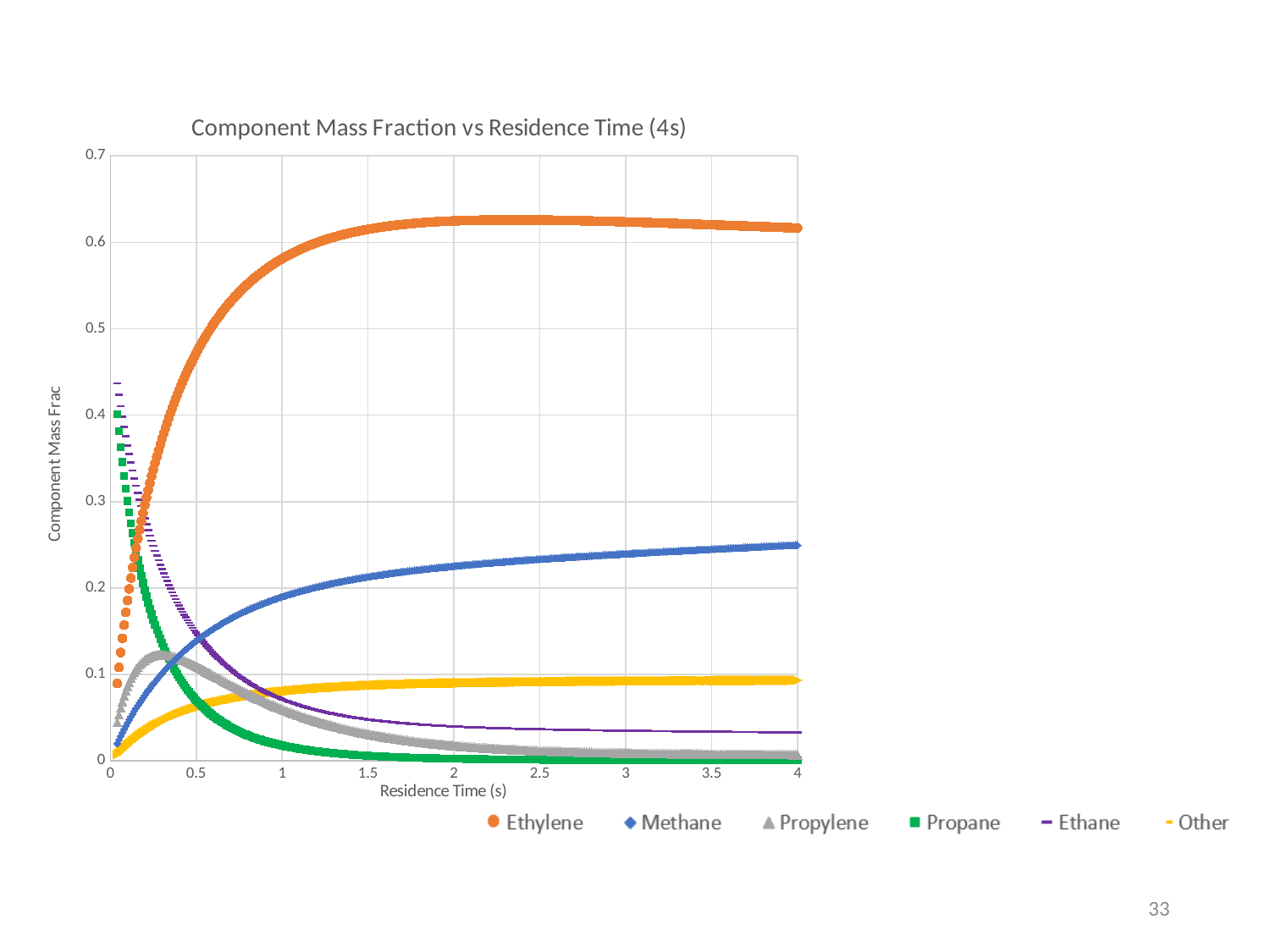
At a residence time of 4 s, which is larger, the value for Methane or the value for Ethane? Methane How many series does the legend list? 6 Is the value for Ethane at a residence time of 4 s greater or less than 0.1? less Does the Methane mass fraction rise or fall as residence time increases? rise Is the value for Methane at a residence time of 1 s greater or less than 0.3? less What kind of chart is shown on the slide? scatter chart Is the value for Ethylene at a residence time of 4 s greater or less than 0.6? greater What is the title of the chart? Component Mass Fraction vs Residence Time (4s) Which series has the highest mass fraction at a residence time of 4 s? Ethylene Does the Propane mass fraction rise or fall as residence time increases? fall What is the label of the x axis? Residence Time (s)